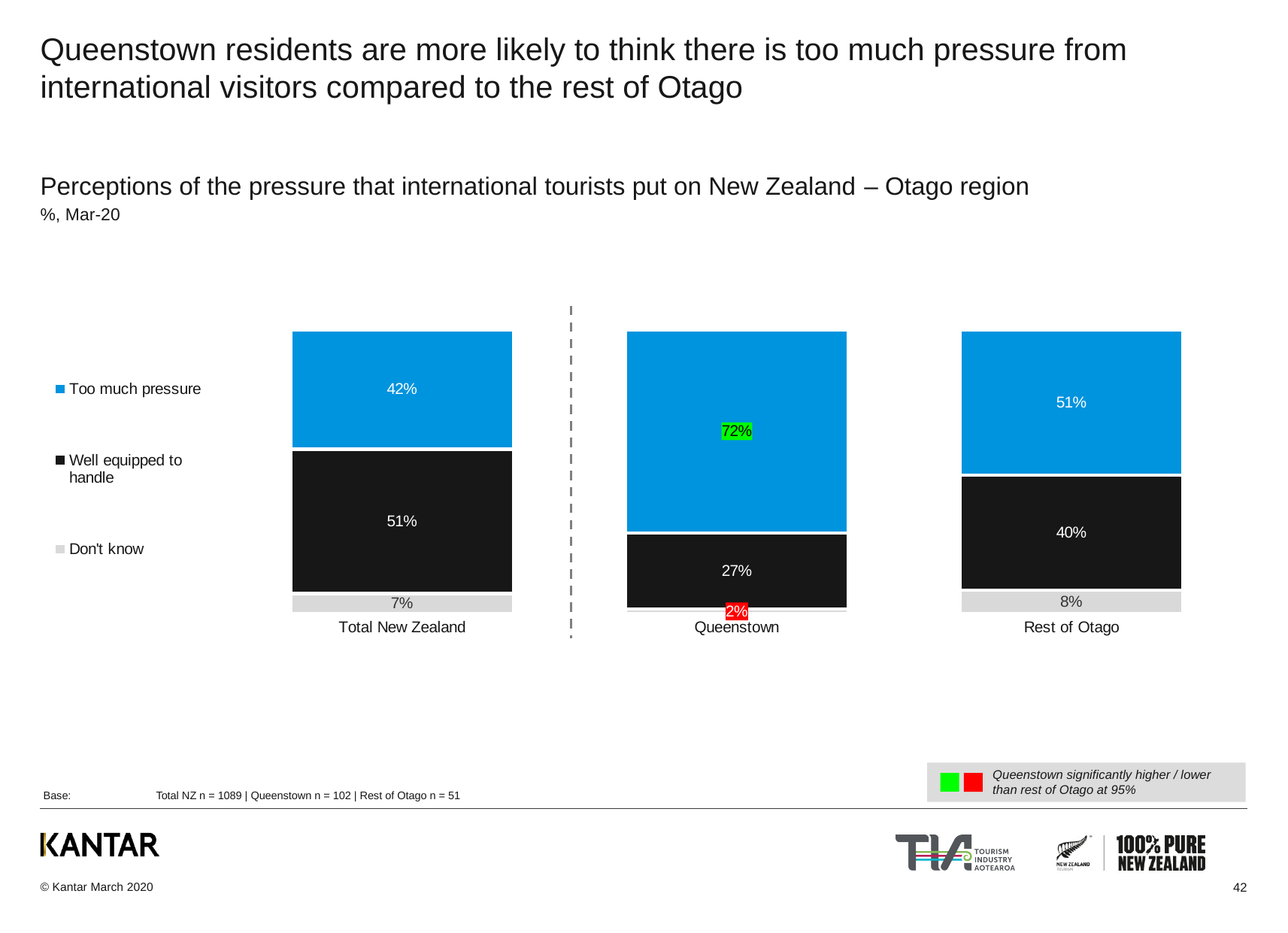
What is the 'Well equipped to handle' value for Rest of Otago? 40% Which region has the highest 'Too much pressure' value? Queenstown What percentage of Queenstown residents think there is too much pressure from international visitors? 72% What is the difference between the 'Too much pressure' values for Queenstown and Rest of Otago? 21 percentage points What kind of chart is shown on the slide? Stacked bar chart Which region has the lowest 'Don't know' value? Queenstown What is the 'Don't know' value for Total New Zealand? 7% What is the total of the three segments in the Rest of Otago bar? 99% Which is larger: the 'Well equipped to handle' value for Total New Zealand or for Queenstown? Total New Zealand How many regions are shown on the x axis of the chart? 3 How many series does the legend list? 3 Which legend entry is shown in blue? Too much pressure